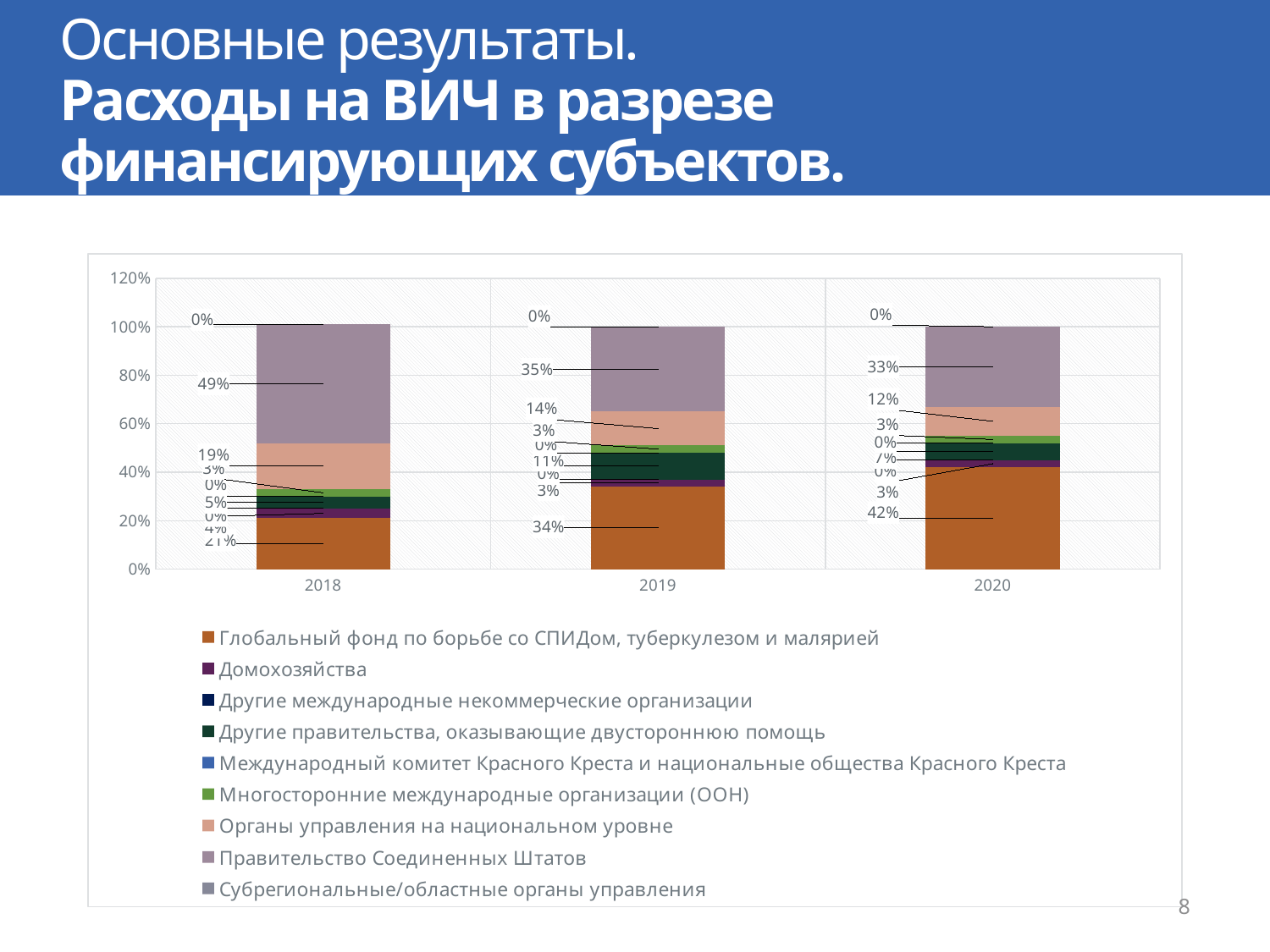
What share of HIV expenditure came from the Правительство Соединенных Штатов in 2020? 33% How many years (categories) are shown on the x axis of the chart? 3 How many series does the chart legend list? 9 What share of HIV expenditure came from the Глобальный фонд по борьбе со СПИДом, туберкулезом и малярией in 2020? 42% In 2020, which is larger: the share of the Глобальный фонд по борьбе со СПИДом, туберкулезом и малярией or the share of the Правительство Соединенных Штатов? Глобальный фонд по борьбе со СПИДом, туберкулезом и малярией What share of HIV expenditure came from the Глобальный фонд по борьбе со СПИДом, туберкулезом и малярией in 2019? 34% What kind of chart is shown on the slide? Stacked bar chart Does the share of the Глобальный фонд по борьбе со СПИДом, туберкулезом и малярией rise or fall from 2018 to 2020? Rises What share of HIV expenditure came from Другие правительства, оказывающие двустороннюю помощь in 2019? 11% What share of HIV expenditure came from the Правительство Соединенных Штатов in 2018? 49% What share of HIV expenditure came from Органы управления на национальном уровне in 2019? 14% By how many percentage points did the share of the Правительство Соединенных Штатов change between 2018 and 2020? 16 percentage points